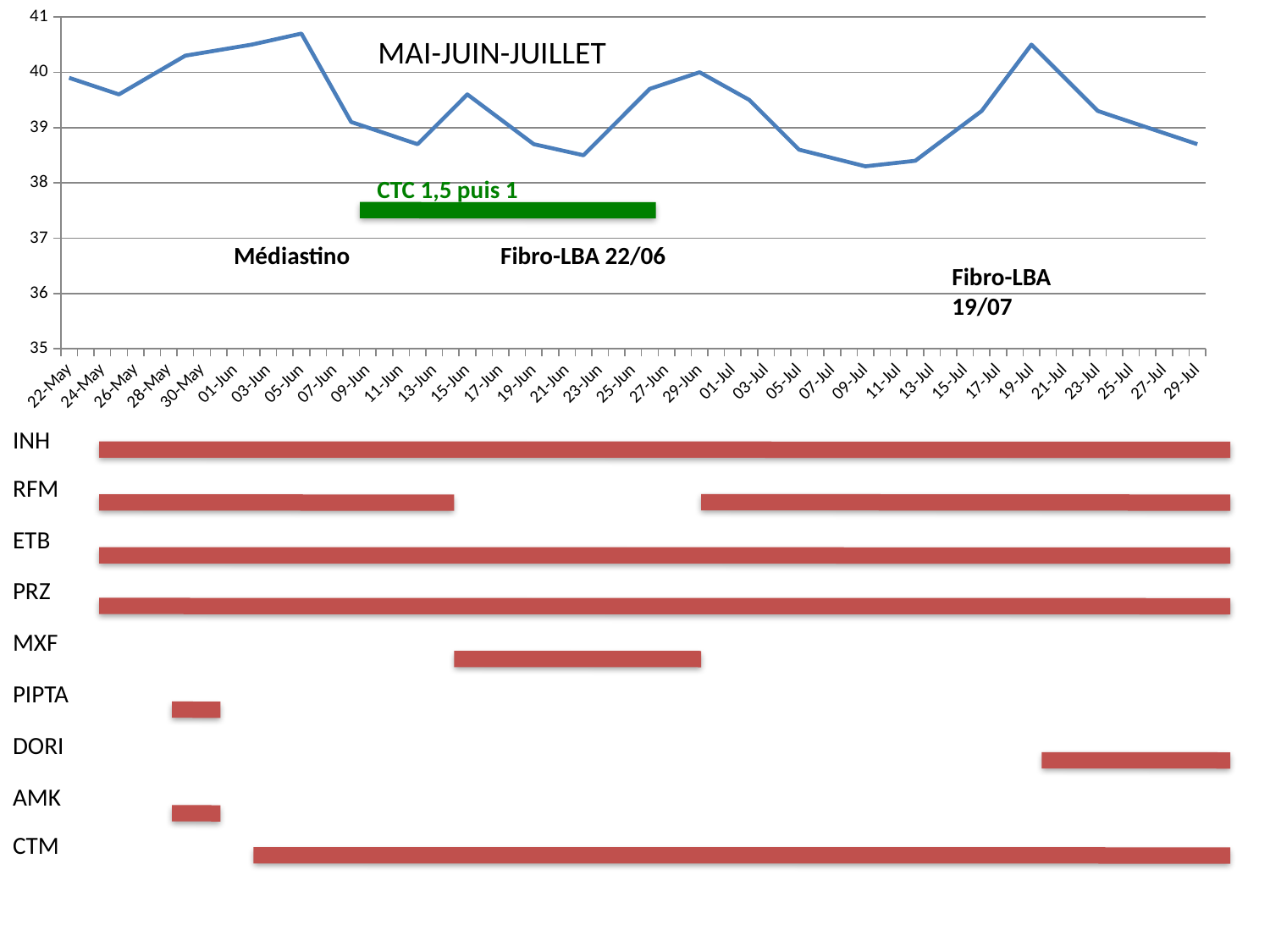
What kind of chart is the top chart on the slide? line chart On the top line chart, which is larger: the value for 05-Jun or the value for 09-Jul? 05-Jun On the top line chart, is the value for 05-Jun greater or less than 40? greater On the top line chart, do the values rise or fall from 05-Jun to 13-Jun? fall What title is shown on the top line chart? MAI-JUIN-JUILLET On the top line chart, is the value for 22-May greater or less than 39? greater On the top line chart, is the value for 19-Jul greater or less than 40? greater On the top line chart, do the values rise or fall from 19-Jul to 29-Jul? fall What text labels the green bar on the top line chart? CTC 1,5 puis 1 On the top line chart, which is larger: the value for 13-Jun or the value for 22-May? 22-May